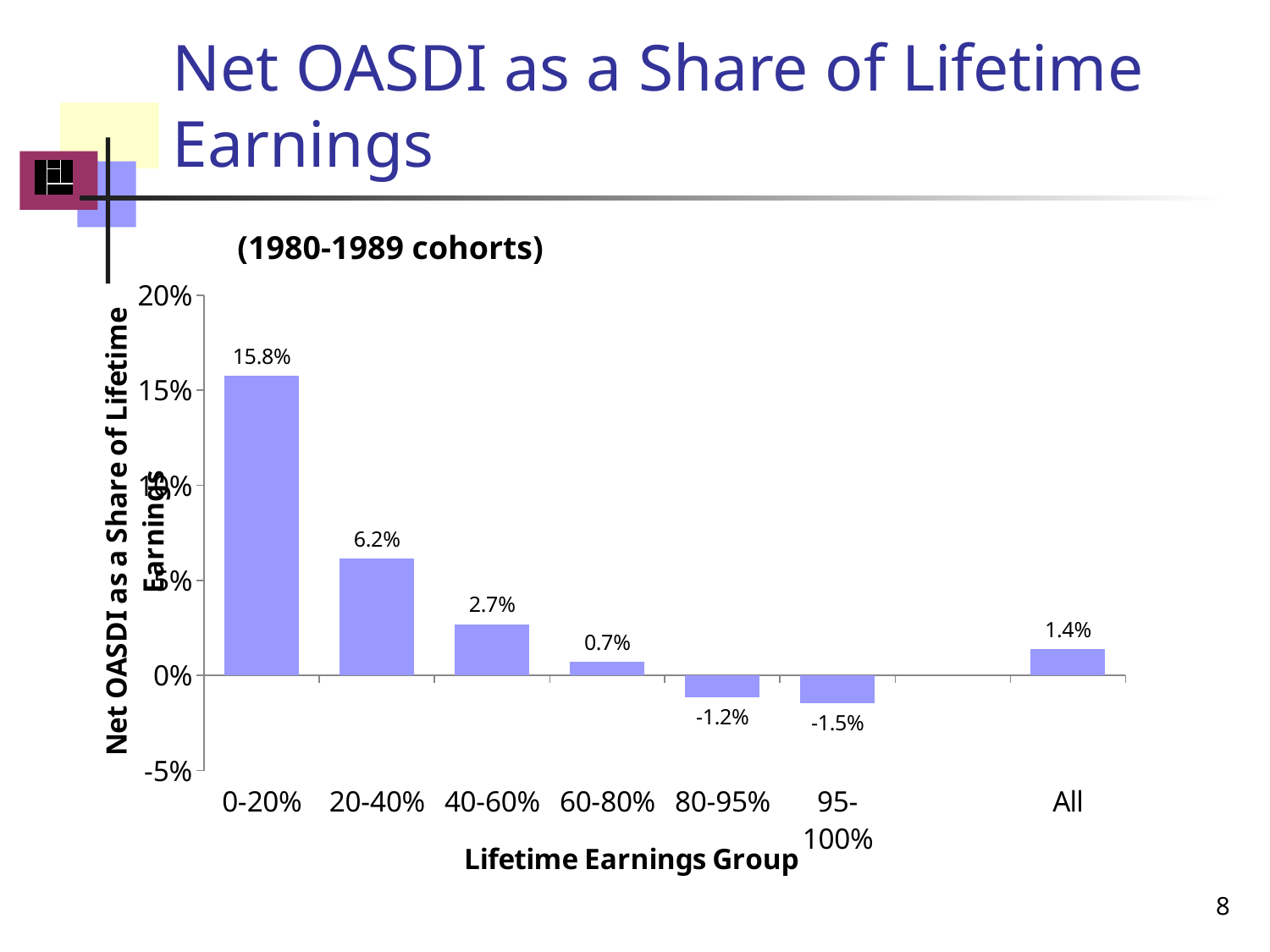
What is the label of the x axis of the chart? Lifetime Earnings Group Do the values rise or fall moving from the 0-20% group to the 95-100% group? Fall How many bars are plotted in the chart? 7 What is the net OASDI share of lifetime earnings for the 0-20% lifetime earnings group? 15.8% What type of chart is shown on the slide? Bar chart What is the difference between the values for the 0-20% group and the 20-40% group? 9.6% Which lifetime earnings group has the lowest net OASDI share of lifetime earnings? 95-100% What is the value shown for the 95-100% lifetime earnings group? -1.5% What is the value shown for the 80-95% lifetime earnings group? -1.2% Which is larger, the value for the 40-60% group or the value for the 'All' category? 40-60% What is the value shown for the 'All' category? 1.4% Which lifetime earnings group has the highest net OASDI share of lifetime earnings? 0-20%